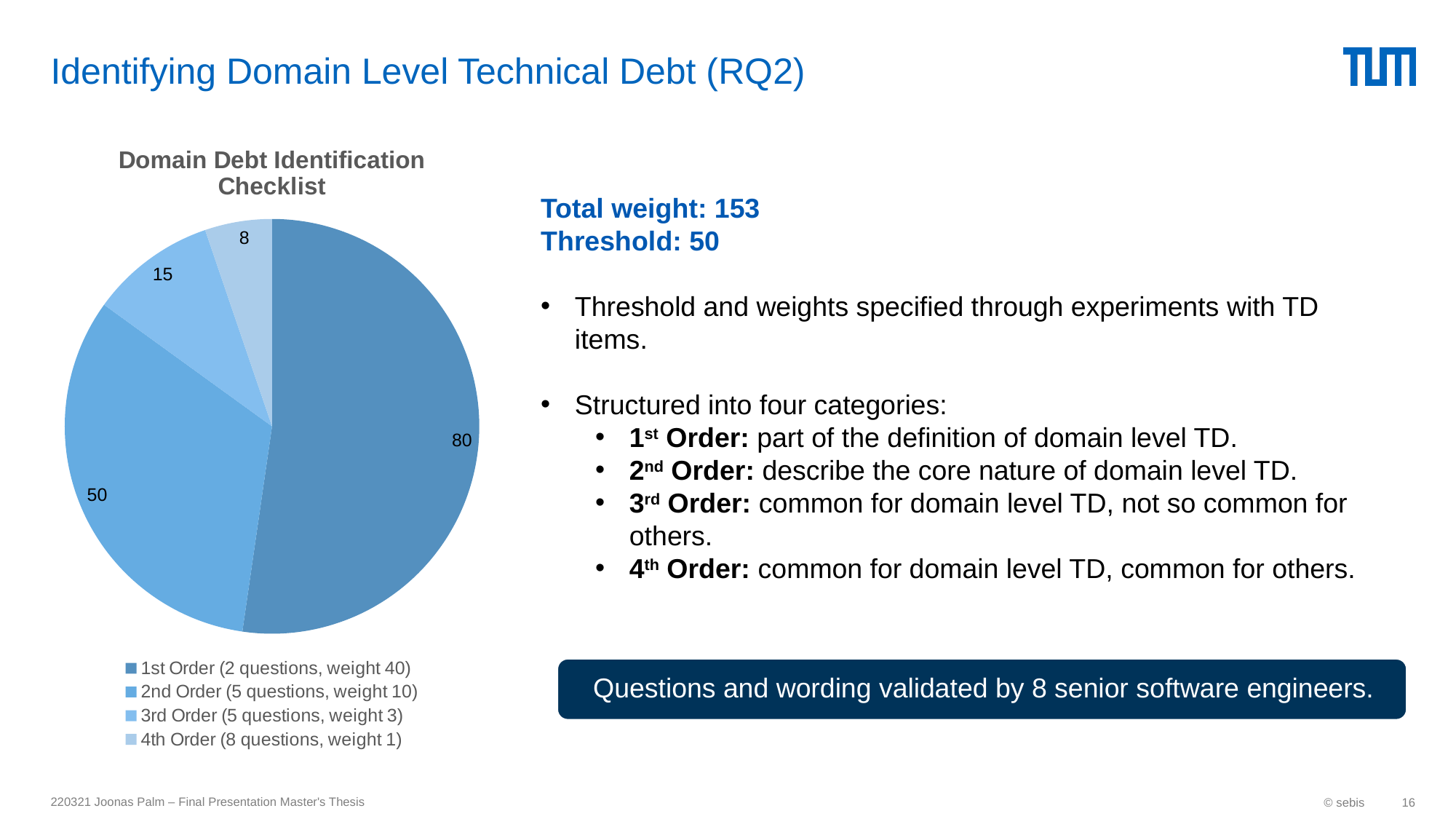
What is the value of the 2nd Order slice in the pie chart? 50 Which category has the smallest slice in the pie chart? 4th Order Which category has the largest slice in the pie chart? 1st Order What is the value of the 4th Order slice in the pie chart? 8 Which is larger in the pie chart, the 3rd Order slice or the 4th Order slice? 3rd Order What is the title of the chart? Domain Debt Identification Checklist What is the value of the 3rd Order slice in the pie chart? 15 How many slices does the pie chart have? 4 What is the value of the 1st Order slice in the pie chart? 80 What type of chart is shown on the slide? Pie chart What is the total of all slice values in the pie chart? 153 What is the difference between the 1st Order and 2nd Order values in the pie chart? 30